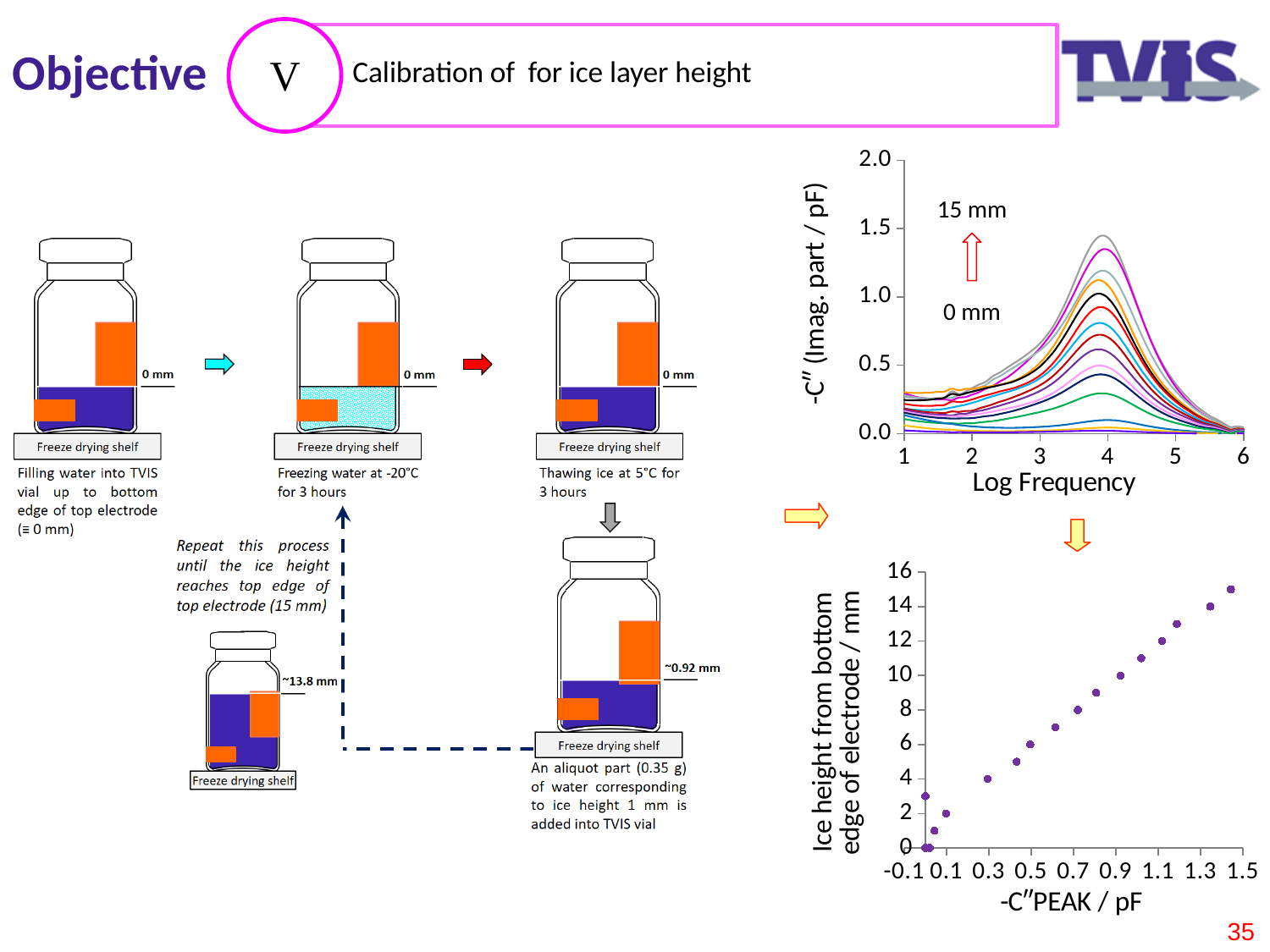
In the top-right line chart, near which Log Frequency tick do the curves reach their peak? 4 In the bottom-right scatter chart, is the -C″PEAK value for the point at 4 mm ice height greater or less than 0.5? less In the bottom-right scatter chart, is the -C″PEAK value for the point at 15 mm ice height greater or less than 1.3? greater What is the x-axis label of the top-right line chart? Log Frequency In the top-right line chart, what is the highest value shown on the y-axis? 2.0 In the bottom-right scatter chart, does ice height rise or fall as -C″PEAK increases? rise In the top-right line chart, is the maximum -C″ value of the highest curve greater or less than 2.0? less What kind of chart is the top-right chart plotting -C″ against Log Frequency? line chart What kind of chart is the bottom-right chart plotting ice height against -C″PEAK? scatter chart